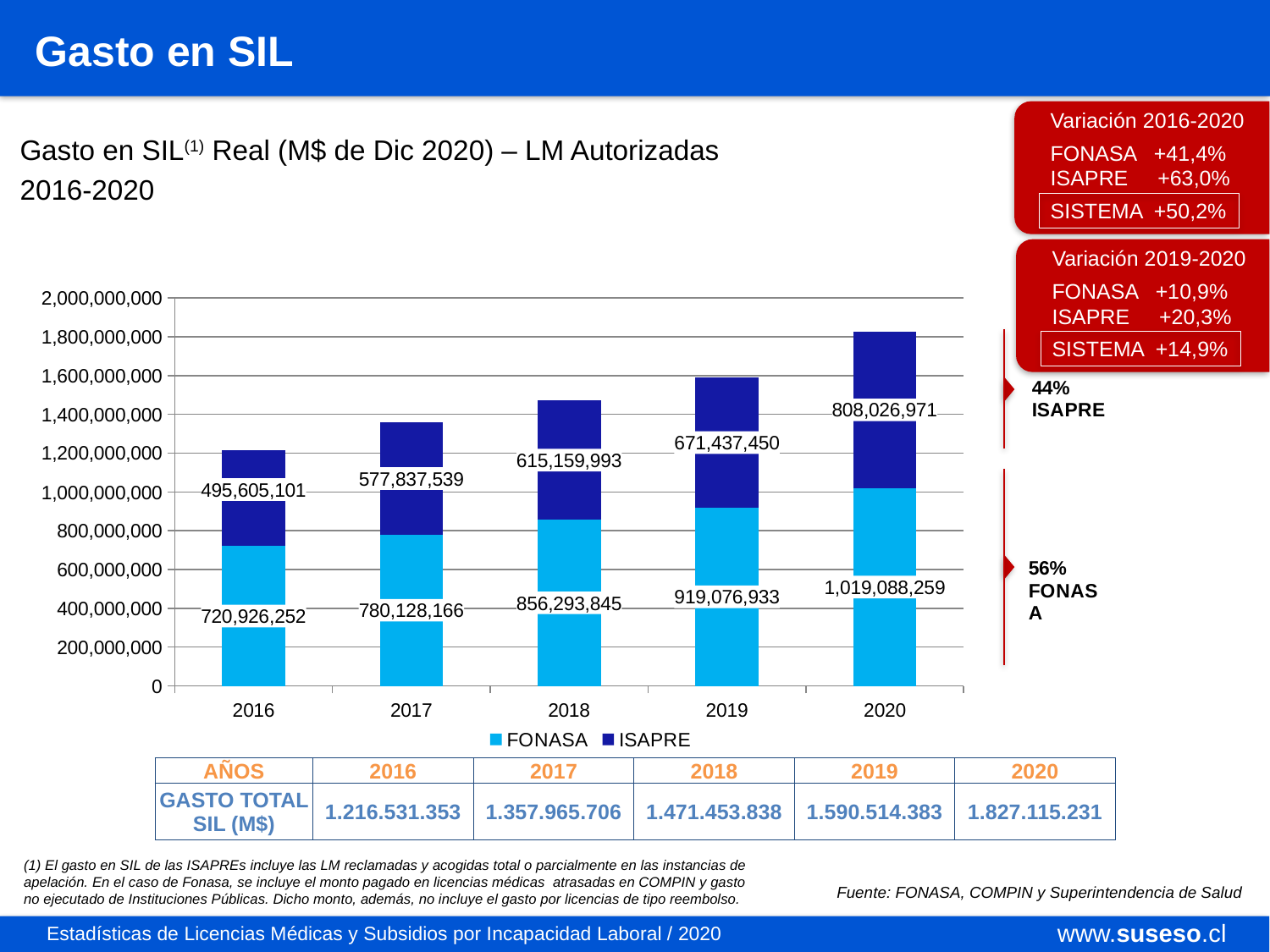
What is the difference between the FONASA value in 2020 and the FONASA value in 2016? 298,162,007 What is the total of the stacked bar for 2016 (FONASA plus ISAPRE)? 1,216,531,353 What kind of chart is shown on the slide? Stacked bar chart In 2019, which is larger, the FONASA value or the ISAPRE value? FONASA What is the FONASA value for 2018? 856,293,845 What is the ISAPRE value for 2020? 808,026,971 Do the total stacked bar heights rise or fall from 2016 to 2020? Rise How many years are shown on the x axis of the chart? 5 Is the ISAPRE value for 2017 greater or less than 600,000,000? less In which year is the FONASA value highest? 2020 In which year is the ISAPRE value lowest? 2016 How many series does the chart legend list? 2